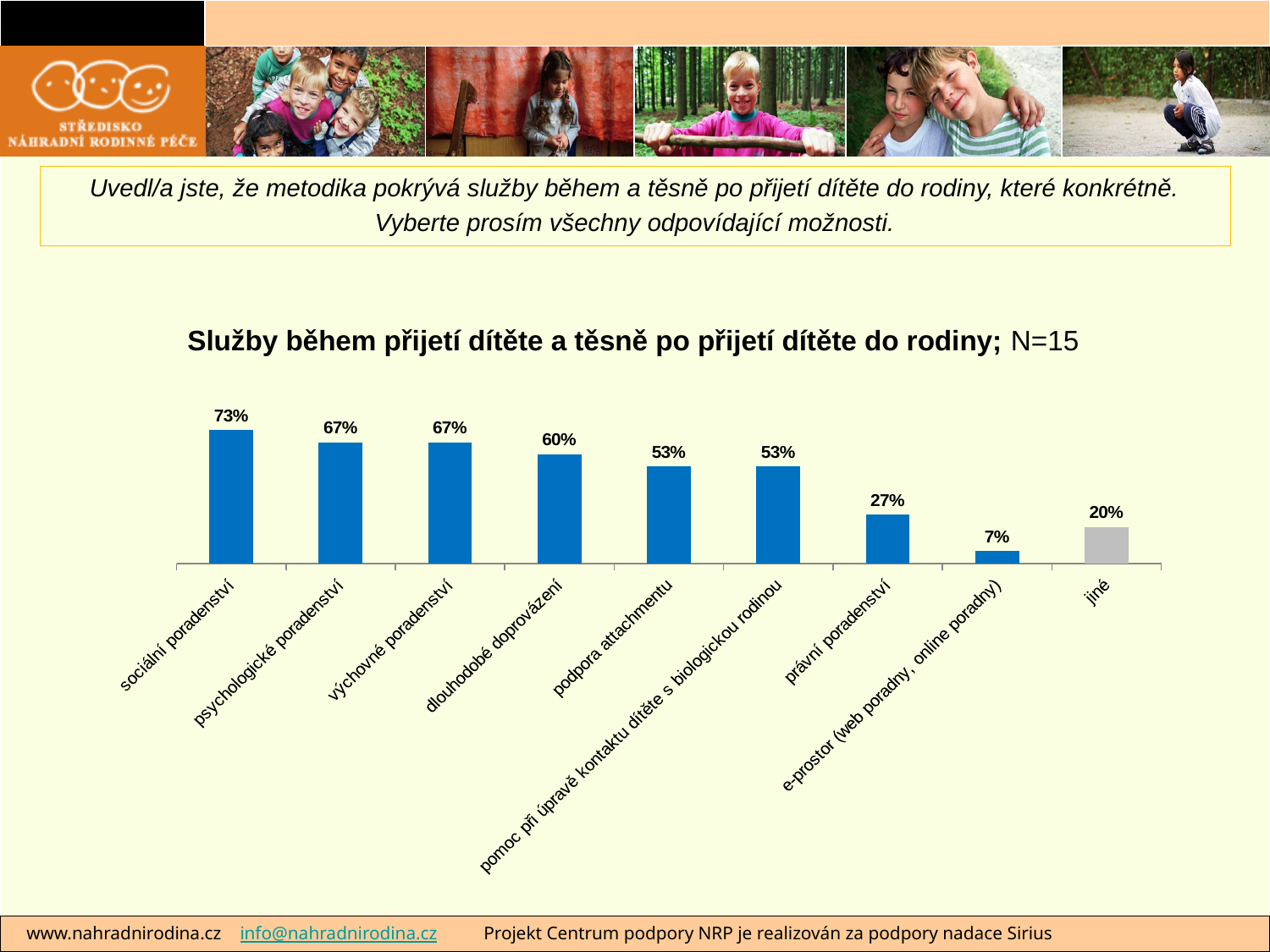
What kind of chart is shown on the slide? bar chart Which category has the highest value? sociální poradenství What is the value for jiné? 20% What is the N value stated in the chart title? N=15 How many categories are shown on the x axis? 9 What is the difference between the values for sociální poradenství and podpora attachmentu? 20% What is the value for dlouhodobé doprovázení? 60% What is the value for právní poradenství? 27% What is the value for sociální poradenství? 73% Do the values rise or fall from left to right along the x axis, ignoring the last bar? fall Which category has the lowest value? e-prostor (web poradny, online poradny) Which is larger, the value for právní poradenství or the value for jiné? právní poradenství